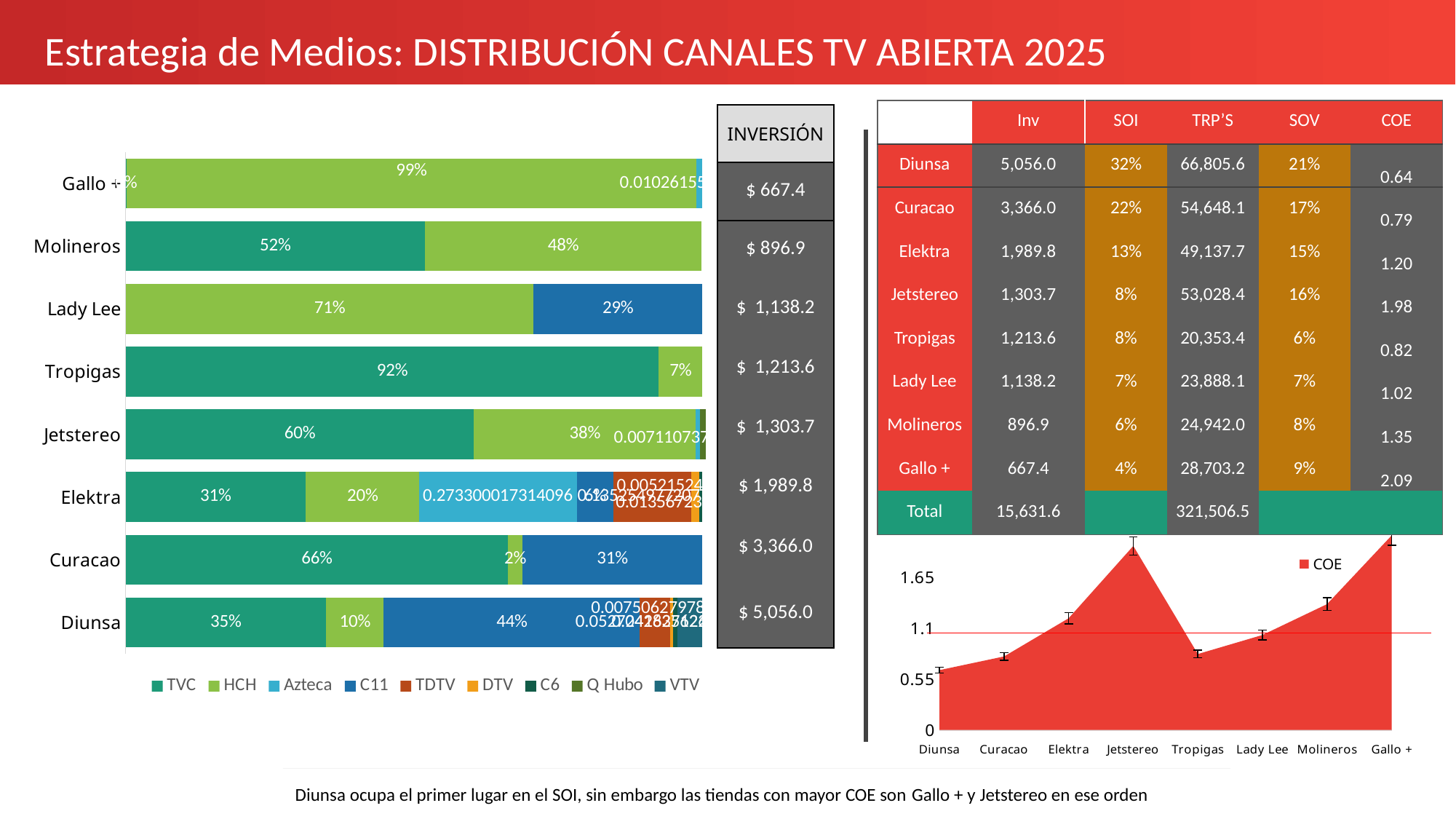
In the left bar chart, what is the difference between the TVC and HCH shares for Molineros? 4% In the COE chart on the right, which store has the highest value? Gallo + In the COE chart on the right, is the value for Jetstereo greater or less than 1.65? greater In the left bar chart, what is the HCH share for Lady Lee? 71% What kind of chart is the COE chart on the right of the slide? area chart What kind of chart is the chart on the left of the slide? bar chart In the left bar chart, what is the C11 share for Diunsa? 44% In the left bar chart, what is the TVC share for Tropigas? 92% How many stores are shown on the left bar chart? 8 How many series does the legend of the left bar chart list? 9 In the left bar chart, which is larger for Curacao: the TVC share or the C11 share? TVC In the COE chart on the right, is the value for Diunsa greater or less than 1.1? less